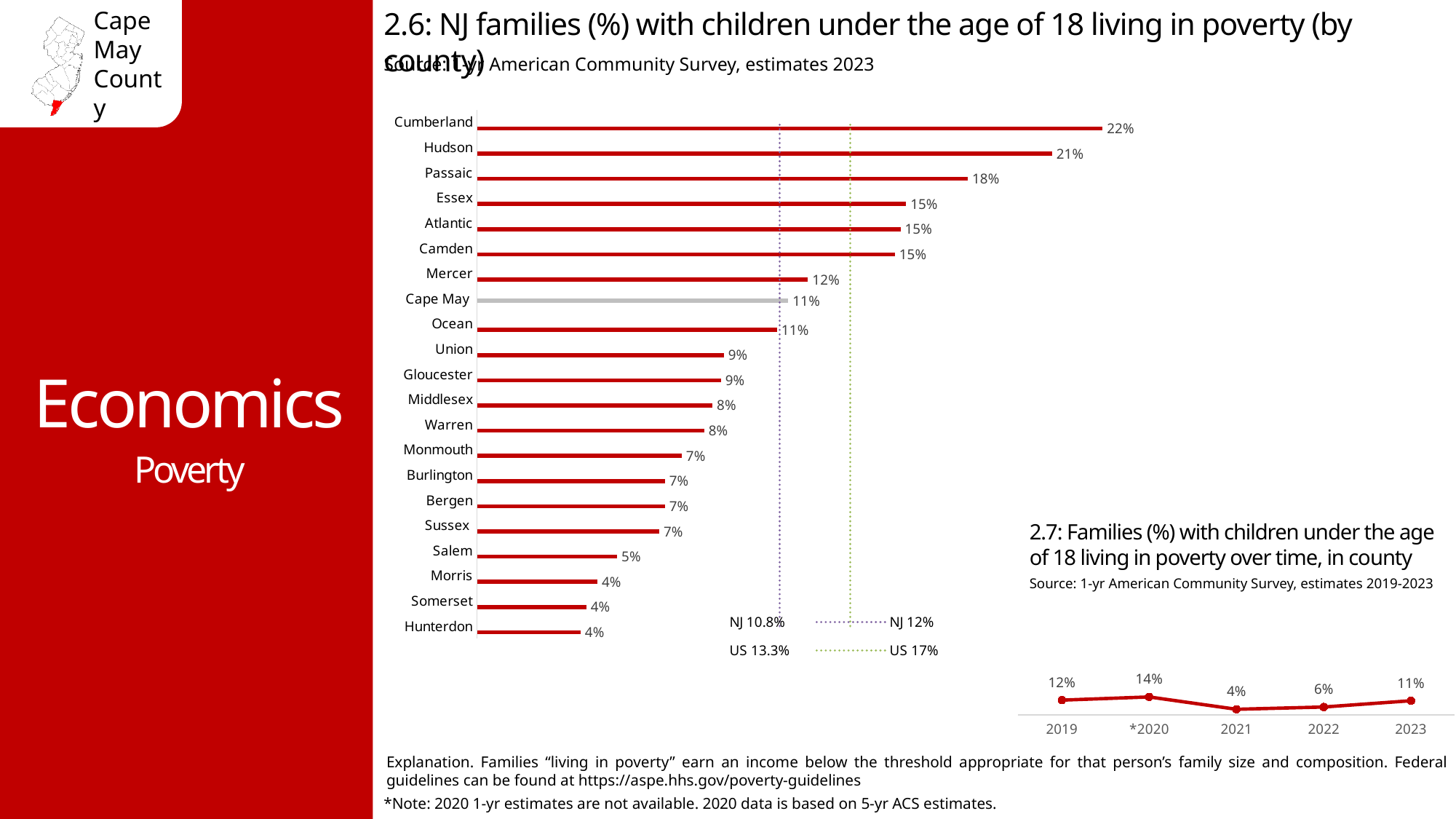
In chart 2.6 (by county), what is the value for Salem? 5% In chart 2.6 (by county), what is the value for Cumberland? 22% In chart 2.6 (by county), how many counties are plotted? 21 In chart 2.6 (by county), which is larger, the value for Passaic or the value for Mercer? Passaic What kind of chart is chart 2.6 (by county)? Bar chart In chart 2.7 (over time, in county), which year has the highest value? *2020 In chart 2.7 (over time, in county), what is the difference between 2023 and 2022? 5% In chart 2.7 (families in poverty over time, in county), what is the value for 2021? 4% In chart 2.6 (NJ families with children under 18 living in poverty by county), what is the value for Cape May? 11% In chart 2.6 (by county), what is the difference between Cumberland and Hunterdon? 18% In chart 2.6 (by county), which county has the highest value? Cumberland